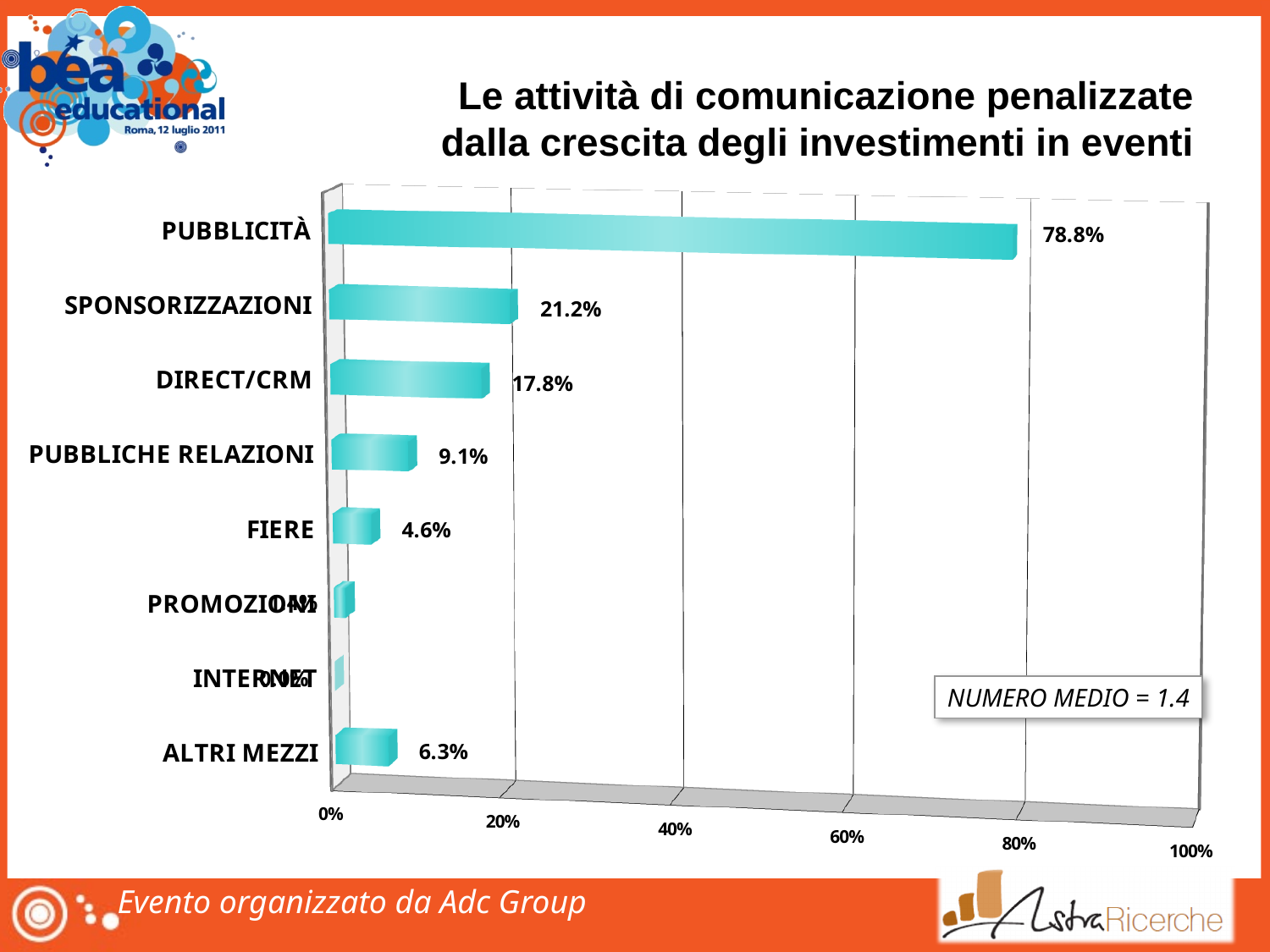
What is the value for ALTRI MEZZI? 6.3% What is the NUMERO MEDIO value shown in the box on the chart? 1.4 What is the value for SPONSORIZZAZIONI? 21.2% What is the value for PUBBLICITÀ? 78.8% Which is larger, the value for FIERE or the value for ALTRI MEZZI? ALTRI MEZZI Which category has the highest value? PUBBLICITÀ What is the value for DIRECT/CRM? 17.8% What is the difference between the values for SPONSORIZZAZIONI and DIRECT/CRM? 3.4% Which category has the lowest value? INTERNET What kind of chart is shown on the slide? bar chart How many categories are shown in the chart? 8 Is the value for PUBBLICITÀ greater or less than 60%? greater